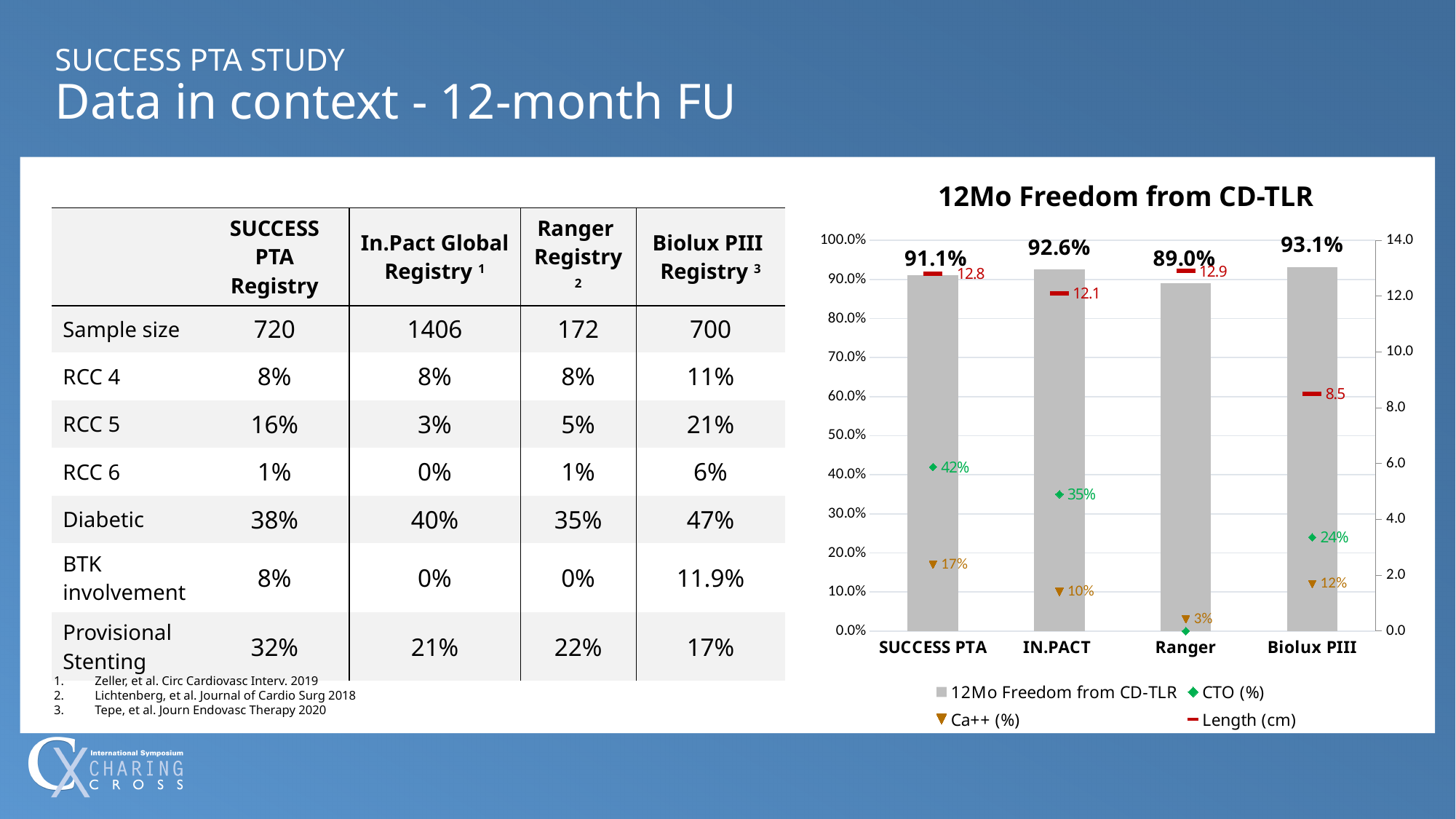
Which has a higher CTO (%) value, SUCCESS PTA or Biolux PIII? SUCCESS PTA Which category has the lowest 12Mo Freedom from CD-TLR? Ranger How many series does the chart legend list? 4 What is the 12Mo Freedom from CD-TLR value for SUCCESS PTA? 91.1% What is the Ca++ (%) value for Ranger? 3% What is the title of the chart? 12Mo Freedom from CD-TLR Which category has the highest 12Mo Freedom from CD-TLR? Biolux PIII How many categories are shown on the x axis of the chart? 4 What is the CTO (%) value for IN.PACT? 35% What is the difference in 12Mo Freedom from CD-TLR between Biolux PIII and Ranger? 4.1% What is the 12Mo Freedom from CD-TLR value for Ranger? 89.0% What is the Length (cm) value for Biolux PIII? 8.5